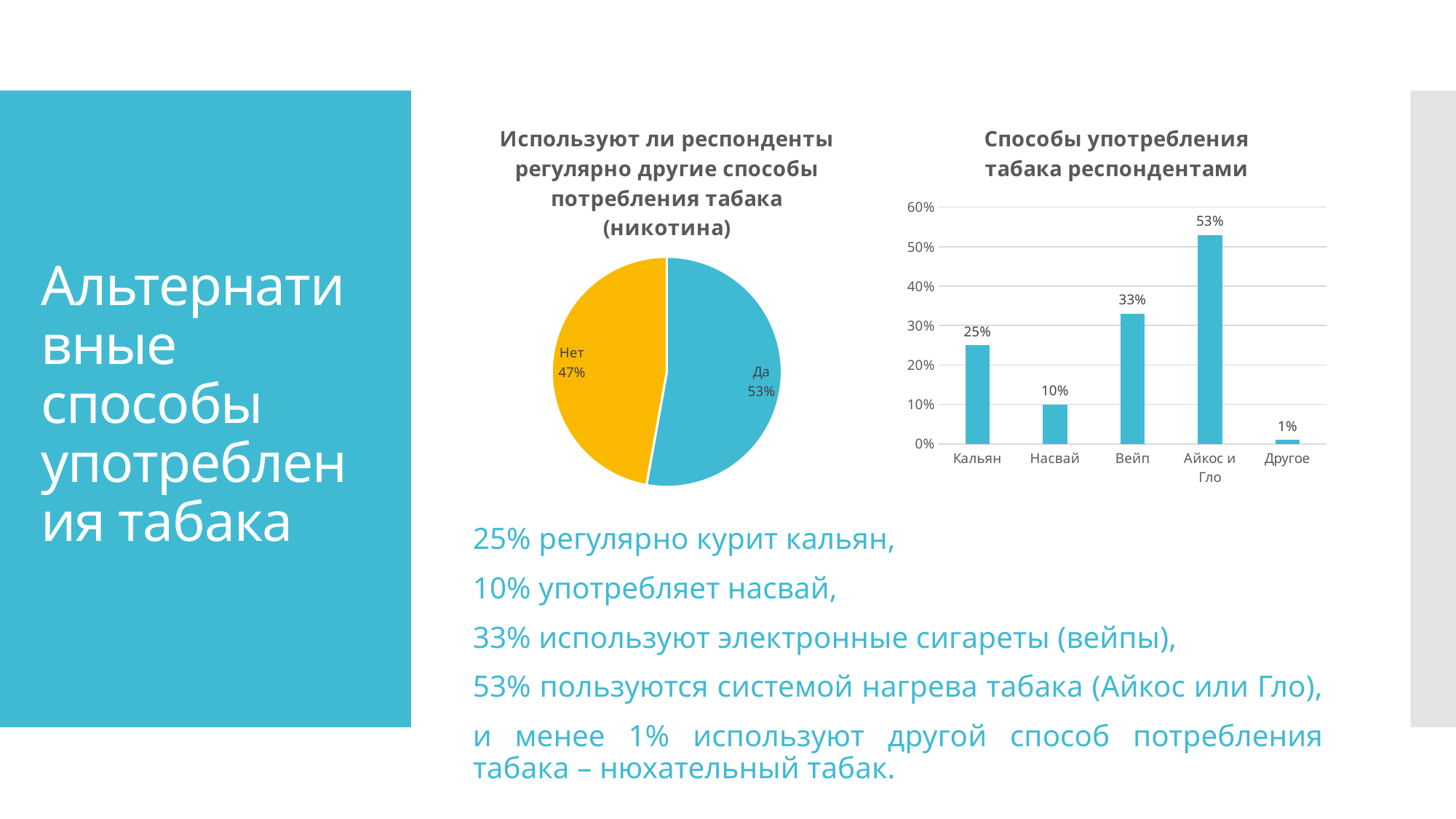
What kind of chart is the chart titled "Способы употребления табака респондентами"? Bar chart In the pie chart on the left, what share of respondents answered "Нет"? 47% In the pie chart on the left, what share of respondents answered "Да"? 53% In the pie chart on the left, which slice is larger, "Да" or "Нет"? Да How many categories are shown in the bar chart "Способы употребления табака респондентами"? 5 In the bar chart "Способы употребления табака респондентами", which category has the highest value? Айкос и Гло In the bar chart "Способы употребления табака респондентами", is the value for "Кальян" greater or less than 20%? greater In the bar chart "Способы употребления табака респондентами", what is the value for "Насвай"? 10% In the bar chart "Способы употребления табака респондентами", which category has the lowest value? Другое In the bar chart "Способы употребления табака респондентами", what is the difference between the values for "Айкос и Гло" and "Кальян"? 28% What kind of chart is the chart on the left? Pie chart In the bar chart "Способы употребления табака респондентами", what is the value for "Вейп"? 33%